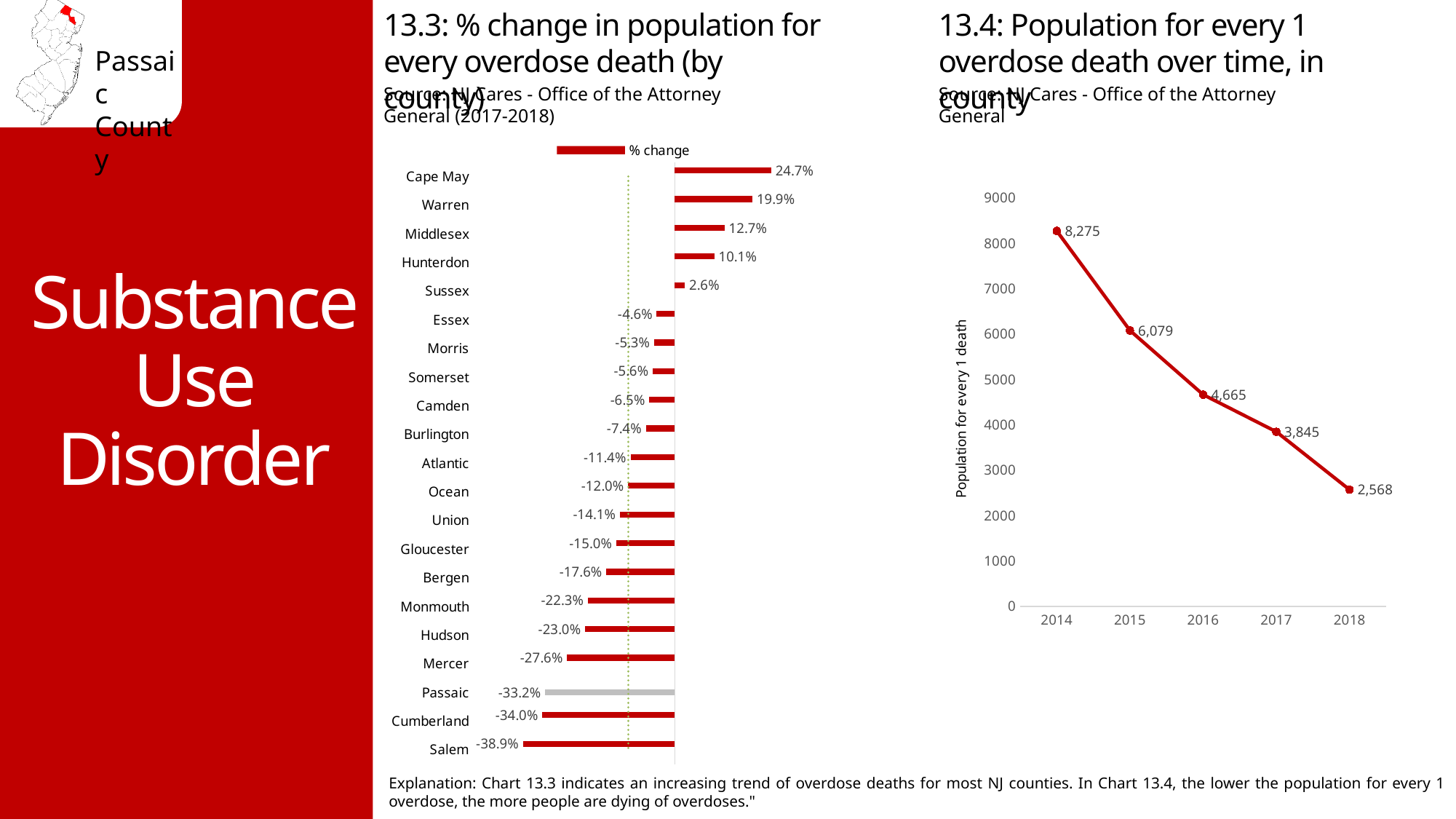
In chart 13.3, how many counties are shown? 21 In chart 13.3, what is the difference between the values for Cape May and Warren? 4.8 percentage points In chart 13.3 (% change in population for every overdose death), what is the value for Passaic? -33.2% In chart 13.4, what is the difference between the 2014 and 2015 values? 2,196 In chart 13.4, do the values rise or fall from 2014 to 2018? fall What kind of chart is chart 13.4? line chart In chart 13.4 (Population for every 1 overdose death over time), what is the value for 2016? 4,665 In chart 13.3, which county has the lowest % change? Salem In chart 13.3, which has a larger % change, Hudson or Mercer? Hudson In chart 13.3, what is the value for Middlesex? 12.7% In chart 13.3, which county has the highest % change? Cape May In chart 13.4, what is the value for 2018? 2,568